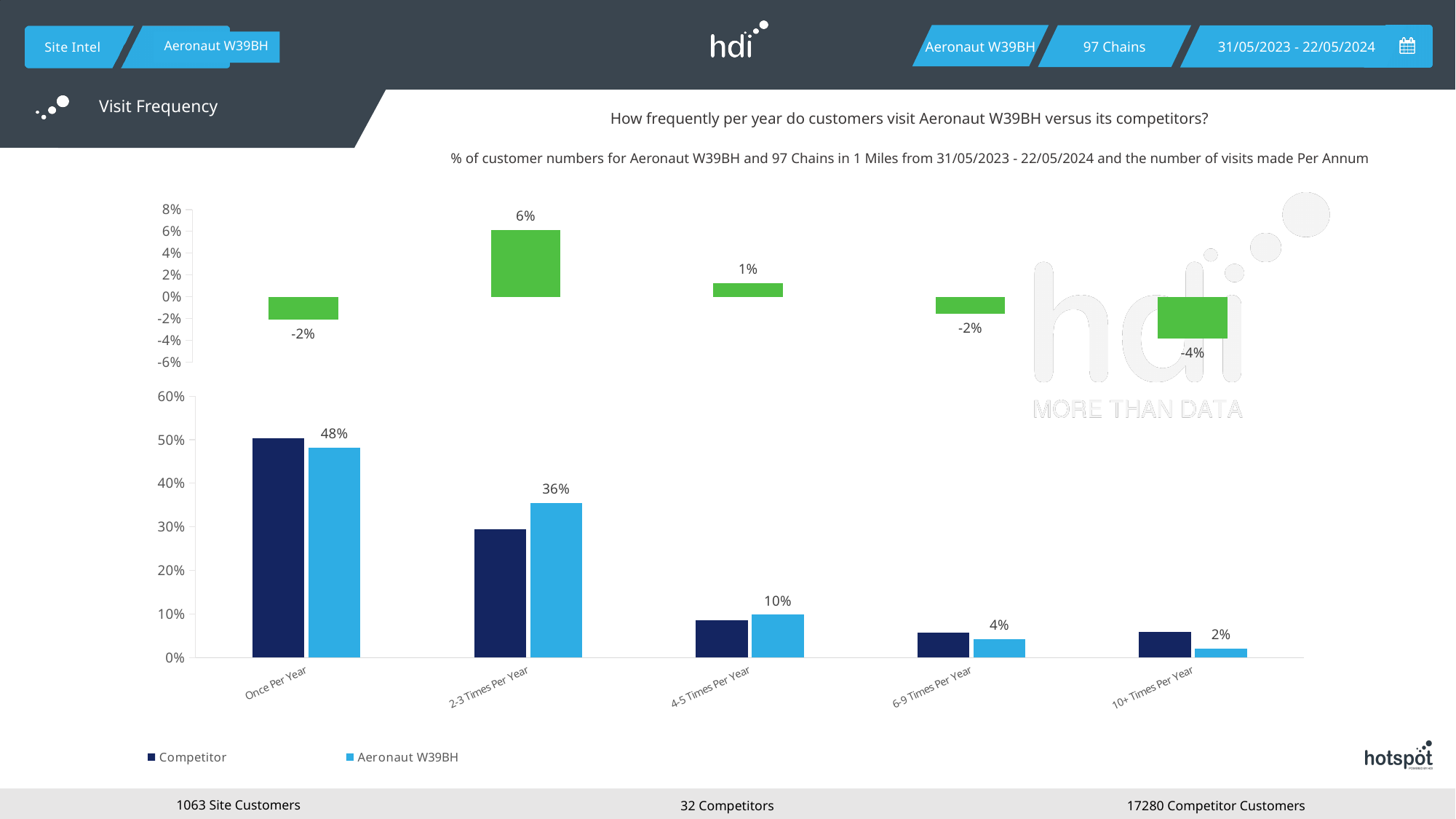
In the top chart, what is the value for 2-3 Times Per Year? 6% In the bottom chart, which category has the highest Aeronaut W39BH value? Once Per Year In the bottom chart, what is the value for Aeronaut W39BH for 2-3 Times Per Year? 36% In the bottom chart, which category has the lowest Aeronaut W39BH value? 10+ Times Per Year In the bottom chart, what is the difference between the Aeronaut W39BH values for Once Per Year and 2-3 Times Per Year? 12% In the bottom chart, is the Competitor value for Once Per Year greater or less than 40%? greater In the top chart, what is the value for 10+ Times Per Year? -4% In the bottom chart, is the Competitor value for 4-5 Times Per Year greater or less than 10%? less In the bottom chart, what is the value for Aeronaut W39BH for 10+ Times Per Year? 2% In the bottom chart, for 6-9 Times Per Year, which is larger: the Competitor bar or the Aeronaut W39BH bar? Competitor How many series does the legend of the bottom chart list? 2 In the bottom chart, what is the value for Aeronaut W39BH for Once Per Year? 48%